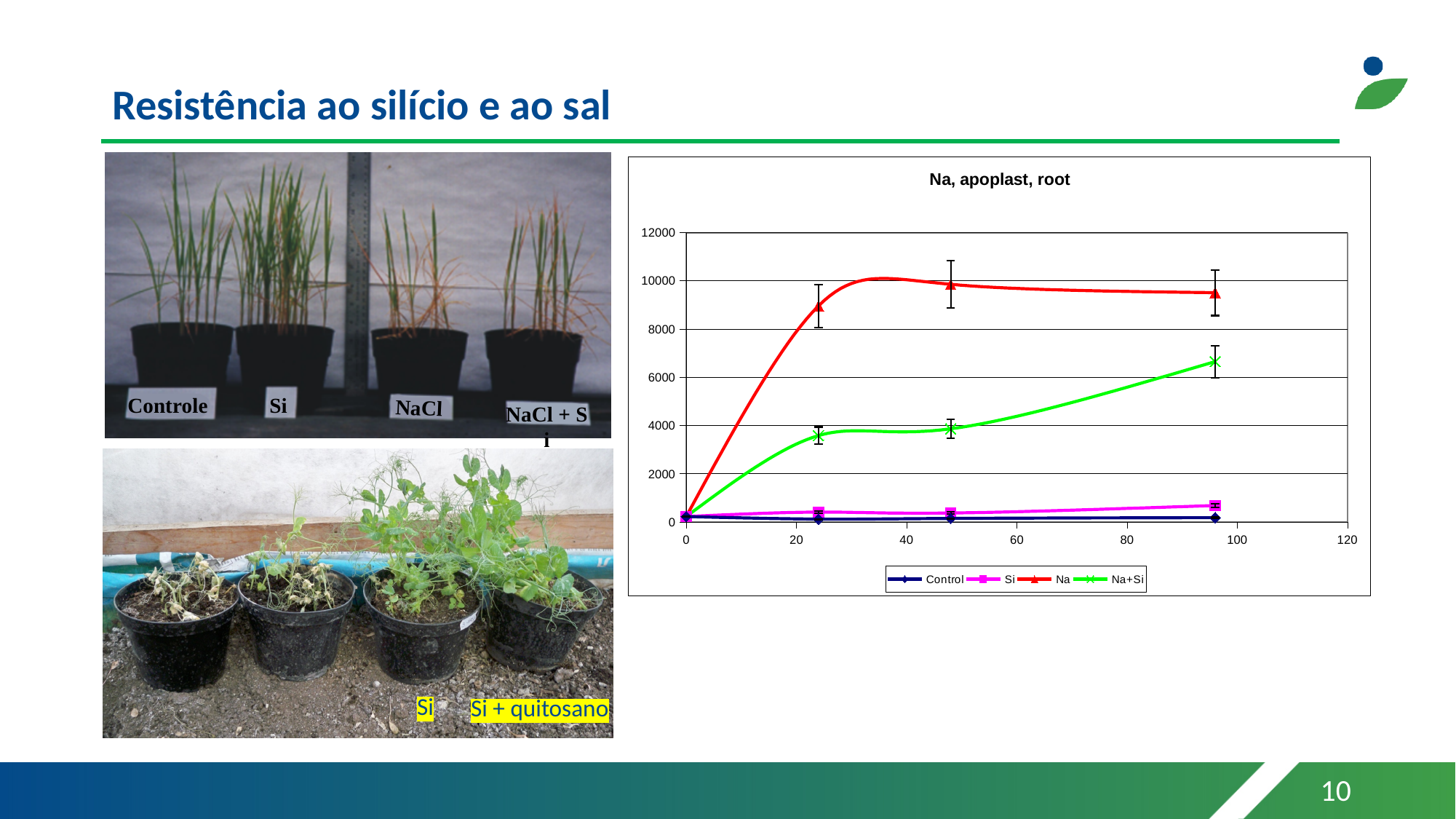
Is the value of the Na series at around x = 48 greater or less than 8000? greater Is the value of the Na+Si series at around x = 24 greater or less than 4000? less Which series has the lowest values on the chart? Control Which series reaches the highest value on the chart? Na Is the value of the Si series at around x = 96 greater or less than 2000? less What colour is the line for the Na series? red Does the Na+Si series rise or fall as x increases from 0 to 96? rise How many series does the chart legend list? 4 At around x = 96, which series has the larger value, Na or Na+Si? Na What is the title of the chart? Na, apoplast, root What kind of chart is shown on the slide? line chart